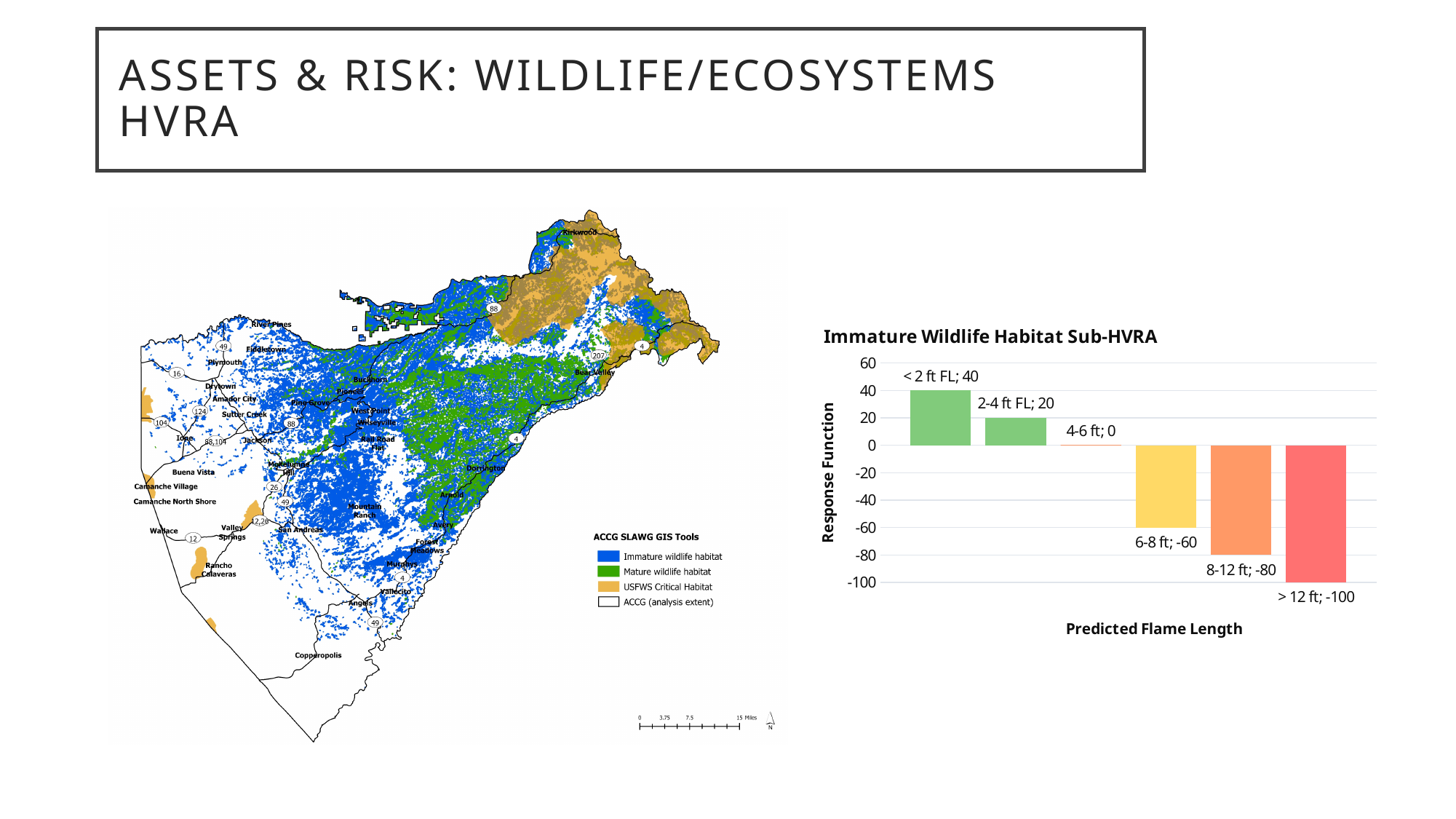
What is the response function value for the 4-6 ft flame length category? 0 What is the label of the y axis in the Immature Wildlife Habitat Sub-HVRA chart? Response Function What kind of chart is the Immature Wildlife Habitat Sub-HVRA chart? Bar chart Do the response function values rise or fall as predicted flame length increases along the x axis? Fall Which flame length category has the lowest response function value? > 12 ft Which flame length category has the highest response function value? < 2 ft FL What is the response function value for the 8-12 ft flame length category? -80 How many flame length categories are plotted in the chart? 6 What is the difference between the response function values for < 2 ft FL and 2-4 ft FL? 20 What is the difference between the response function values for 6-8 ft and > 12 ft? 40 What is the response function value for the < 2 ft FL category in the Immature Wildlife Habitat Sub-HVRA chart? 40 Which has a larger response function value, 2-4 ft FL or 6-8 ft? 2-4 ft FL